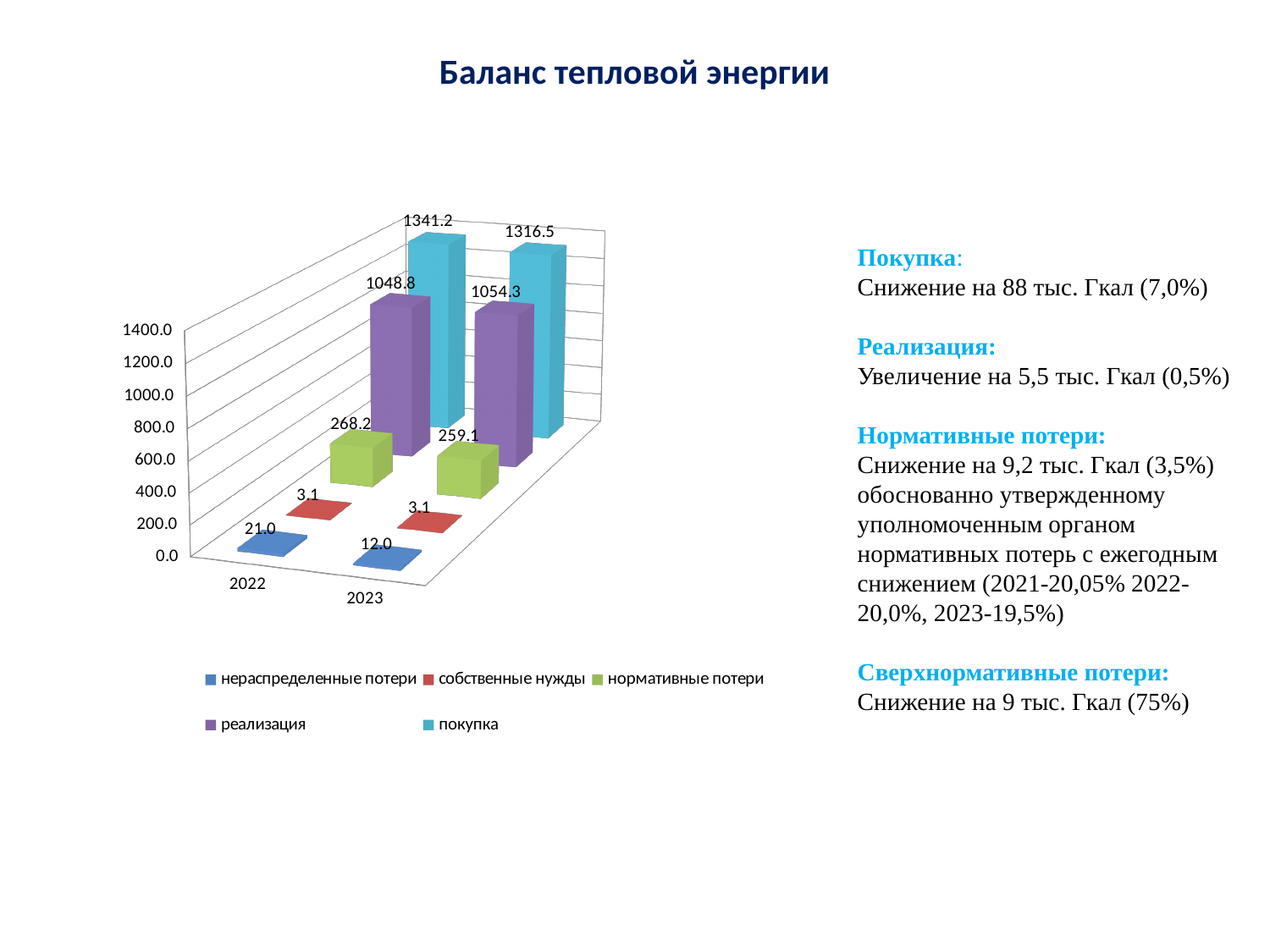
What is the title of the slide's chart section? Баланс тепловой энергии What kind of chart is shown on the slide? bar chart What is the value for нераспределенные потери in 2023? 12.0 What is the value for реализация in 2023? 1054.3 How many series does the legend list? 5 Which series has the lowest value in 2022? собственные нужды Which is larger: реализация in 2022 or реализация in 2023? реализация in 2023 What is the value for нормативные потери in 2022? 268.2 What is the value for собственные нужды in 2022? 3.1 Which series has the highest value in 2023? покупка What is the value for покупка in 2022? 1341.2 What is the difference between the покупка values for 2022 and 2023? 24.7